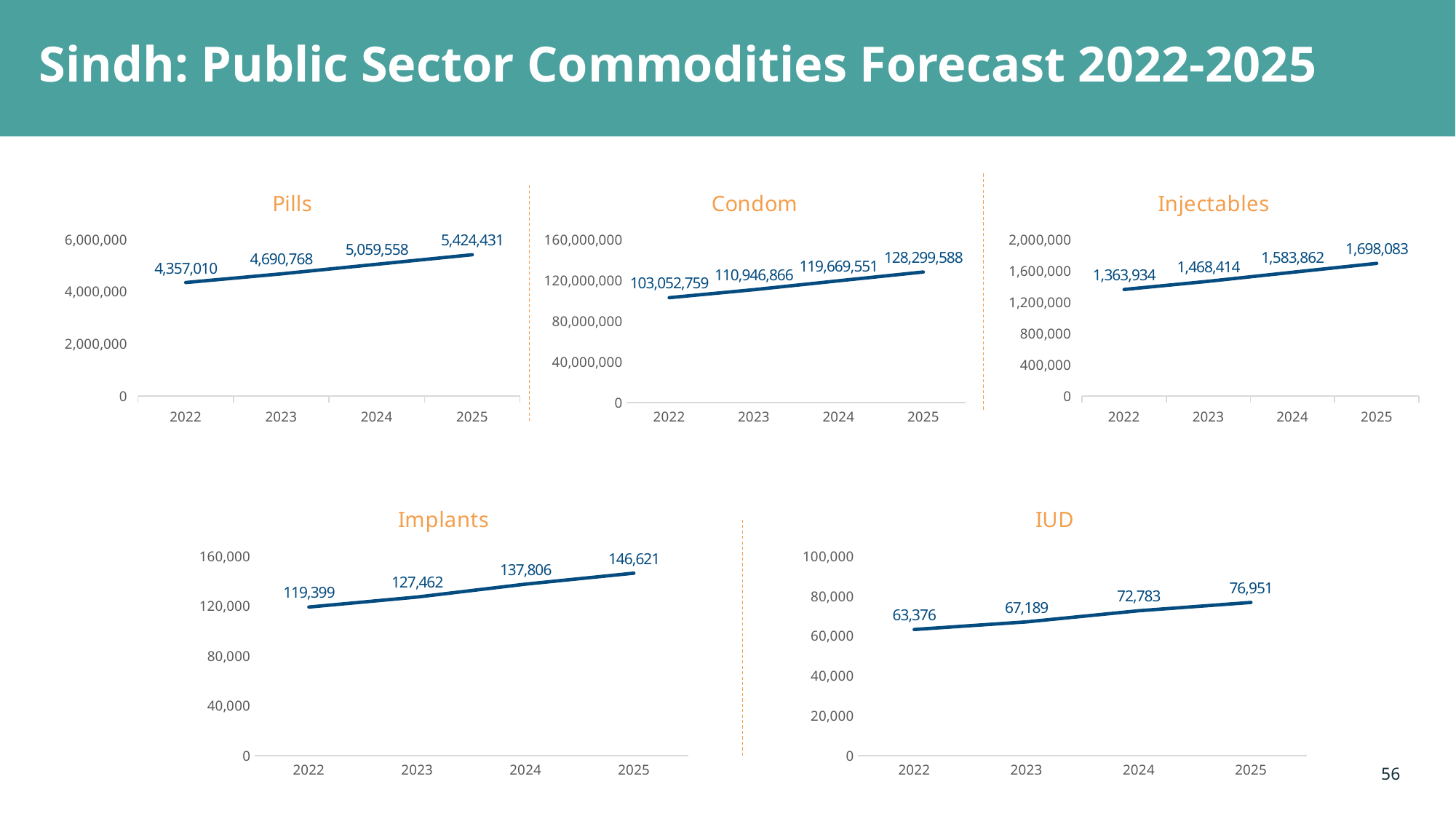
In the Implants chart, do the forecast values rise or fall from 2022 to 2025? rise What kind of chart is the Condom chart? line chart In the Implants chart, what is the forecast value for 2023? 127,462 In the Pills chart, what is the difference between the 2025 and 2022 forecast values? 1,067,421 In the Condom chart, which year has the highest forecast value? 2025 In the Injectables chart, what is the forecast value for 2024? 1,583,862 In the Condom chart, what is the forecast value for 2022? 103,052,759 How many years are plotted on the x axis of the Injectables chart? 4 In the IUD chart, which year has the lowest forecast value? 2022 In the Pills chart, what is the forecast value for 2025? 5,424,431 In the IUD chart, what is the difference between the 2025 and 2022 forecast values? 13,575 In the IUD chart, what is the forecast value for 2025? 76,951